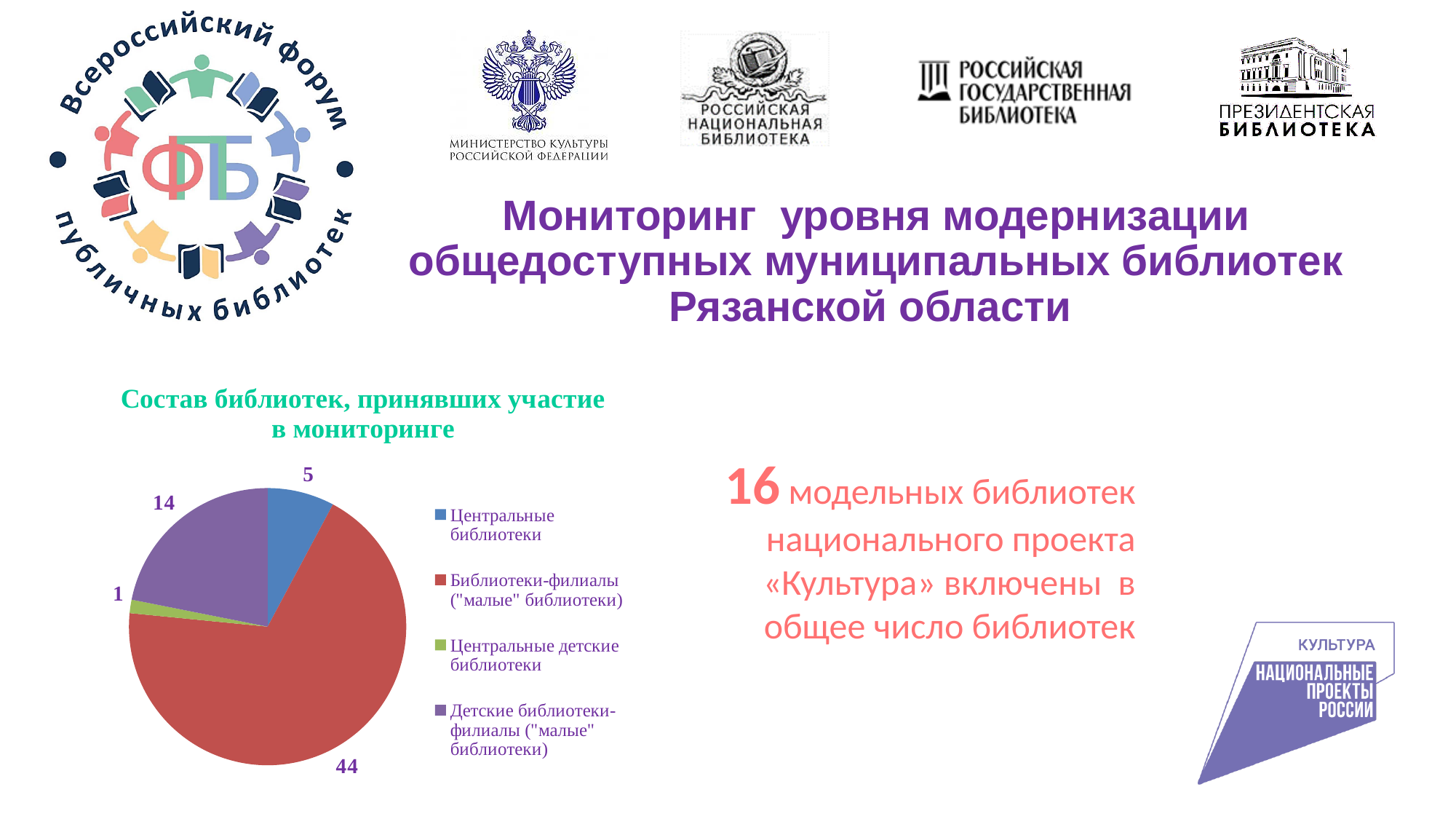
What is the value for Центральные детские библиотеки? 1 What is the value for Детские библиотеки-филиалы ("малые" библиотеки)? 14 Which category has the largest slice of the pie? Библиотеки-филиалы ("малые" библиотеки) What kind of chart is shown on the slide? pie chart What is the title of the chart? Состав библиотек, принявших участие в мониторинге Which is larger: the value for Центральные библиотеки or the value for Детские библиотеки-филиалы ("малые" библиотеки)? Детские библиотеки-филиалы ("малые" библиотеки) What is the total of all slices in the pie chart? 64 What is the value for Центральные библиотеки? 5 Which category has the smallest slice of the pie? Центральные детские библиотеки What is the difference between the values for Библиотеки-филиалы ("малые" библиотеки) and Детские библиотеки-филиалы ("малые" библиотеки)? 30 What is the value for Библиотеки-филиалы ("малые" библиотеки)? 44 How many slices does the pie chart have? 4